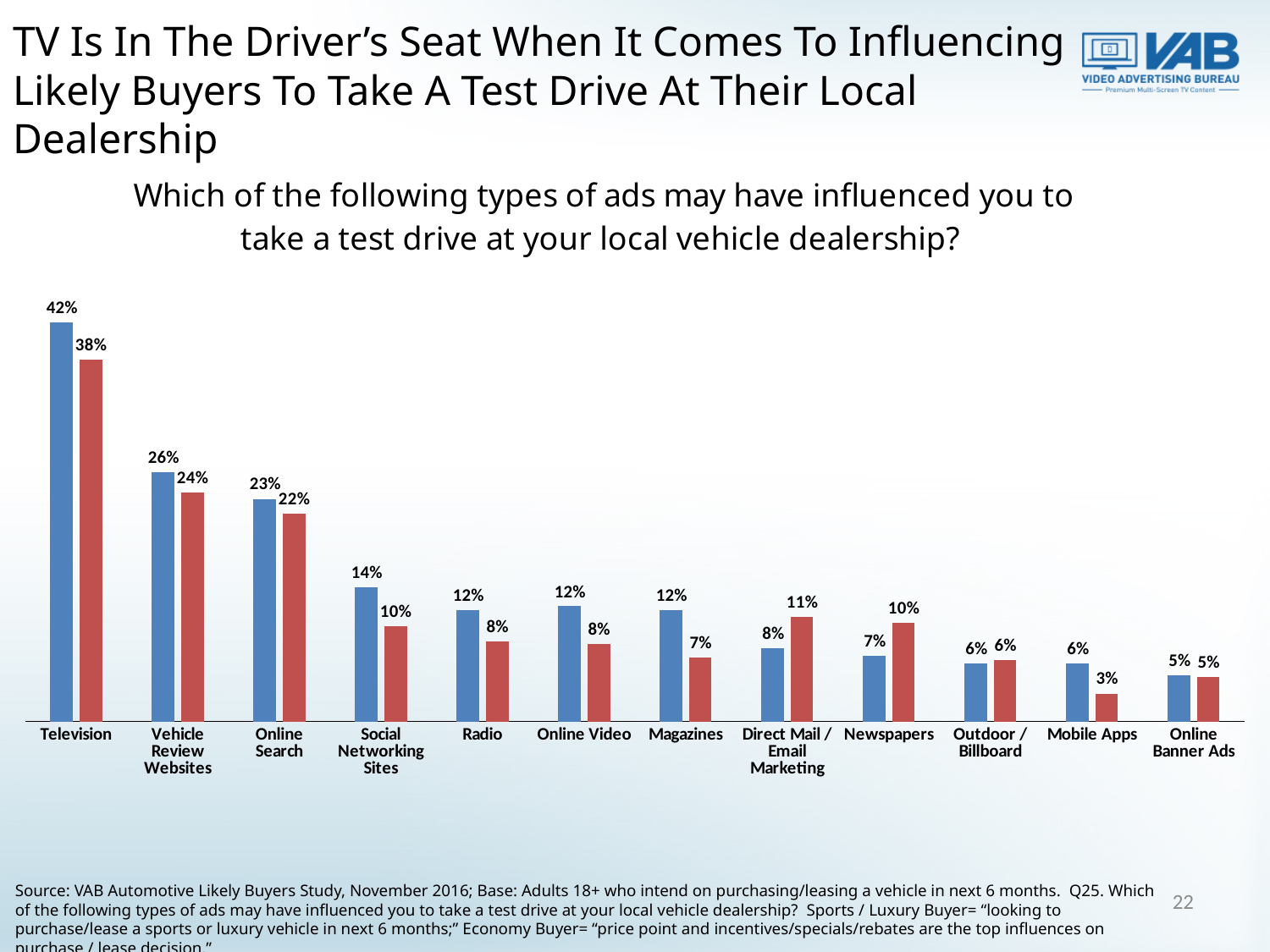
What is the value of the blue bar for Television? 42% For Direct Mail / Email Marketing, which bar is larger, the blue or the red? red What type of chart is shown on the slide? bar chart Which is larger, the blue bar for Radio or the blue bar for Outdoor / Billboard? Radio How many ad type categories are shown on the x axis? 12 What is the value of the red bar for Mobile Apps? 3% Which category has the lowest red bar? Mobile Apps What is the value of the blue bar for Social Networking Sites? 14% What is the difference between the blue and red bars for Television? 4% What is the difference between the blue bar for Vehicle Review Websites and the blue bar for Online Search? 3% What is the value of the red bar for Newspapers? 10% Which category has the highest blue bar? Television